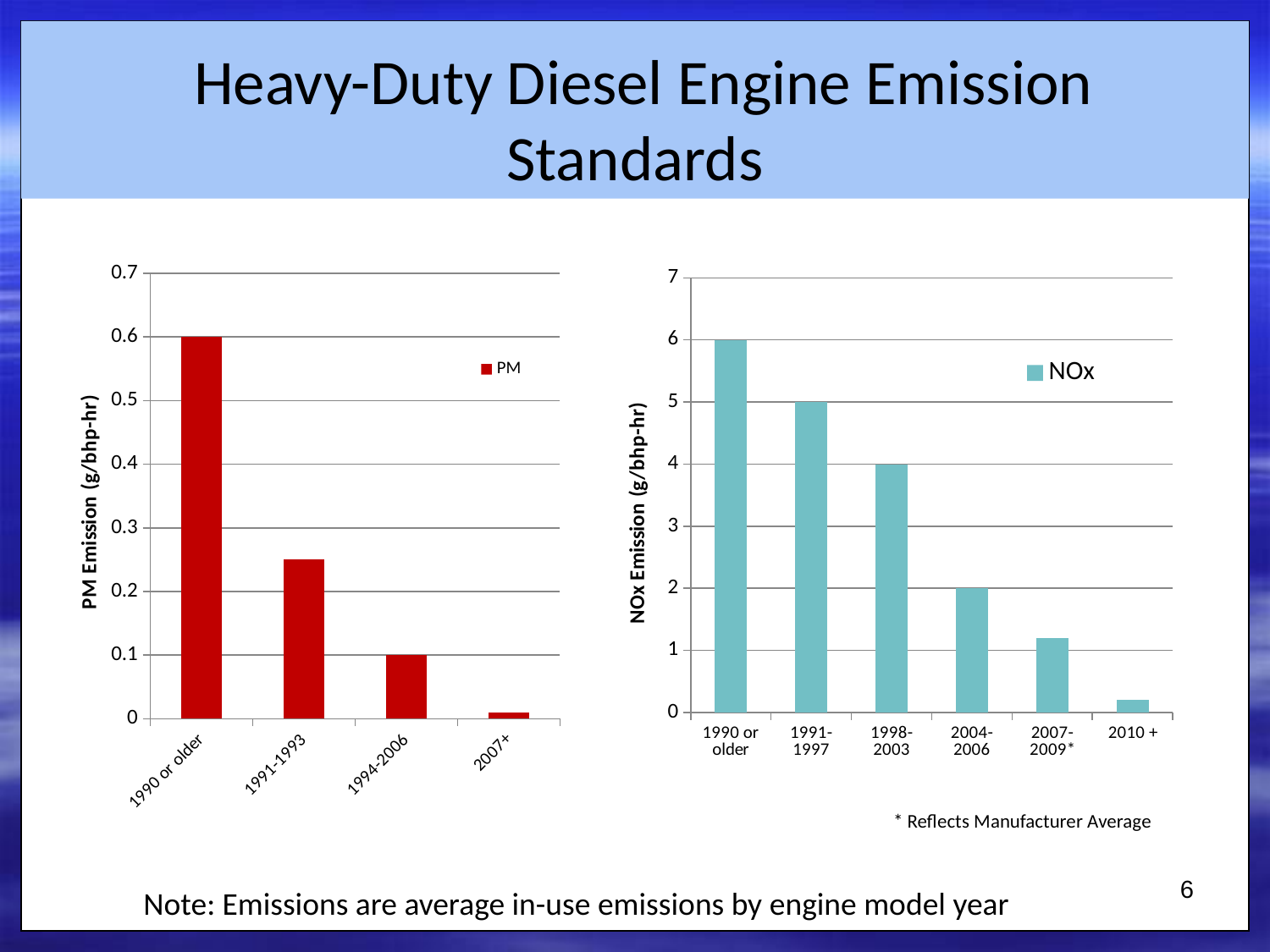
In the left chart (PM Emission), is the value for 1991-1993 greater or less than 0.2? greater What kind of chart is the left chart (PM Emission)? bar chart How many categories are shown on the x axis of the right chart (NOx Emission)? 6 In the right chart (NOx Emission), is the value for 2010 + greater or less than 1? less In the left chart (PM Emission), what is the PM emission value for engines 1990 or older? 0.6 In the right chart (NOx Emission), do the values rise or fall from left to right along the x axis? fall In the left chart (PM Emission), which category has the highest PM emission? 1990 or older In the right chart (NOx Emission), what is the NOx emission value for engines 1990 or older? 6 In the right chart (NOx Emission), which category has the lowest NOx emission? 2010 + In the left chart (PM Emission), what is the PM emission value for the 1994-2006 category? 0.1 In the right chart (NOx Emission), what is the NOx emission value for the 1998-2003 category? 4 In the right chart (NOx Emission), what is the difference between the NOx values for 1991-1997 and 2004-2006? 3